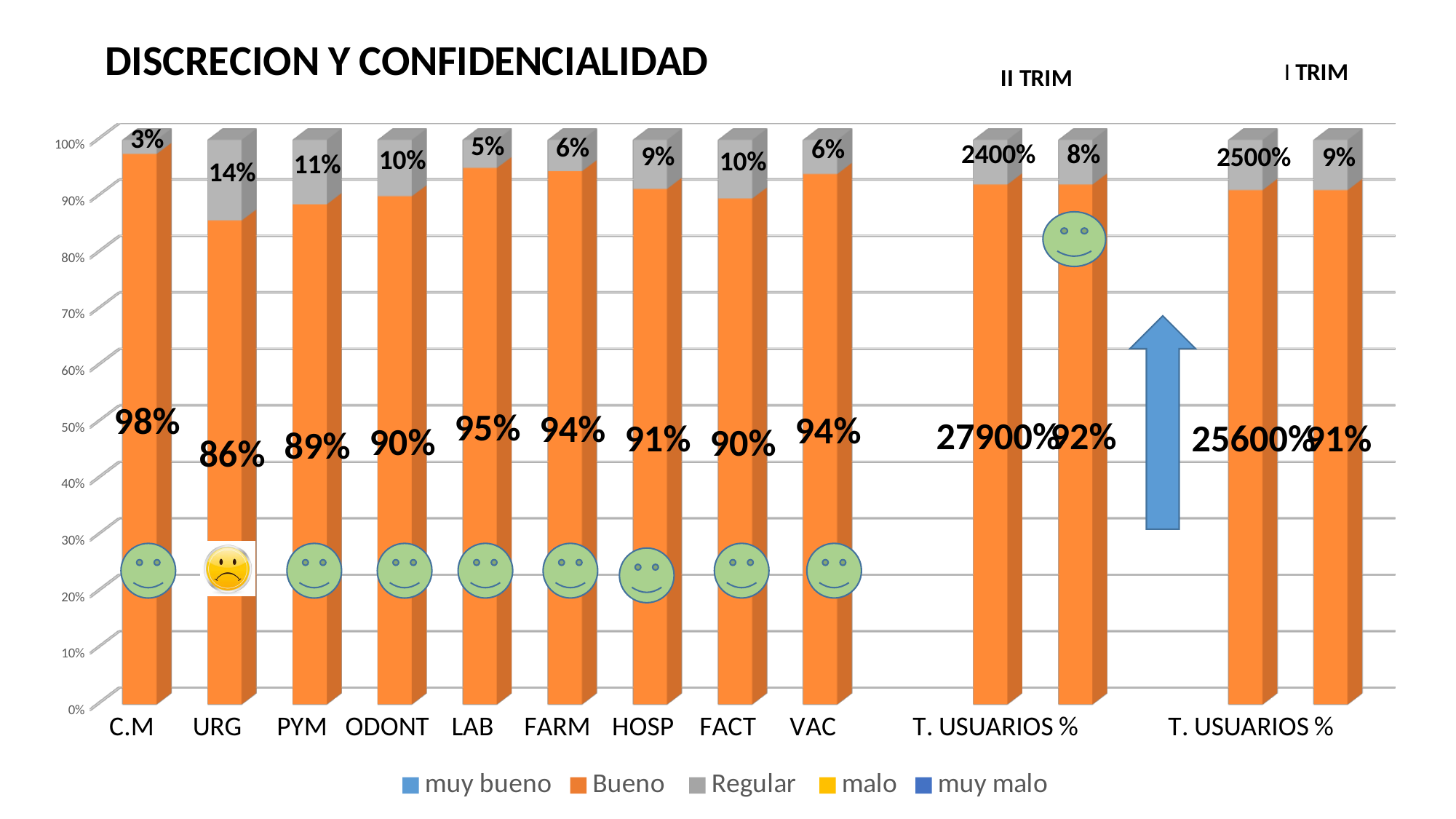
What is the Regular value for URG? 14% How many series does the legend list? 5 What kind of chart is shown on the slide? Stacked bar chart What is the Bueno value for LAB? 95% Which has a larger Regular value, PYM or FARM? PYM Among C.M, URG, PYM, ODONT, LAB, FARM, HOSP, FACT and VAC, which category has the highest Bueno value? C.M Is the Bueno value for URG greater or less than 90%? less What is the Regular value for HOSP? 9% Among C.M, URG, PYM, ODONT, LAB, FARM, HOSP, FACT and VAC, which category has the lowest Bueno value? URG What is the difference between the Bueno values for C.M and URG? 12% What is the title of the chart? DISCRECION Y CONFIDENCIALIDAD What is the Bueno value for C.M? 98%